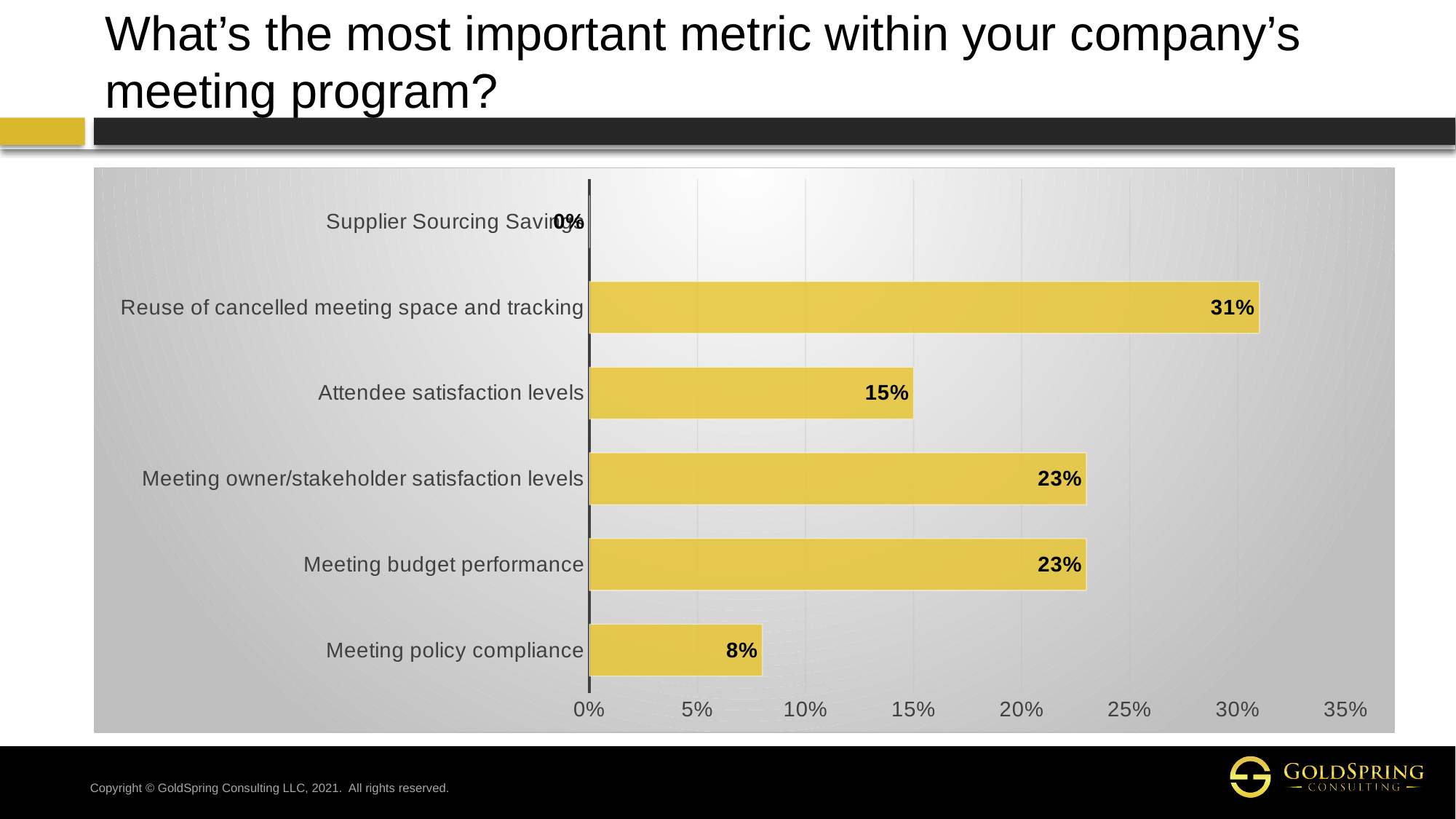
What is the title of the slide containing the chart? What's the most important metric within your company's meeting program? What is the value for Reuse of cancelled meeting space and tracking? 31% What kind of chart is shown on the slide? Bar chart Which is larger: Meeting budget performance or Meeting policy compliance? Meeting budget performance What is the difference between Reuse of cancelled meeting space and tracking and Attendee satisfaction levels? 16% Which category has the highest value? Reuse of cancelled meeting space and tracking Is the value for Meeting owner/stakeholder satisfaction levels greater or less than 20%? greater What is the value for Attendee satisfaction levels? 15% What is the value for Supplier Sourcing Savings? 0% Which category has the lowest value? Supplier Sourcing Savings What is the value for Meeting policy compliance? 8% How many categories are shown in the chart? 6